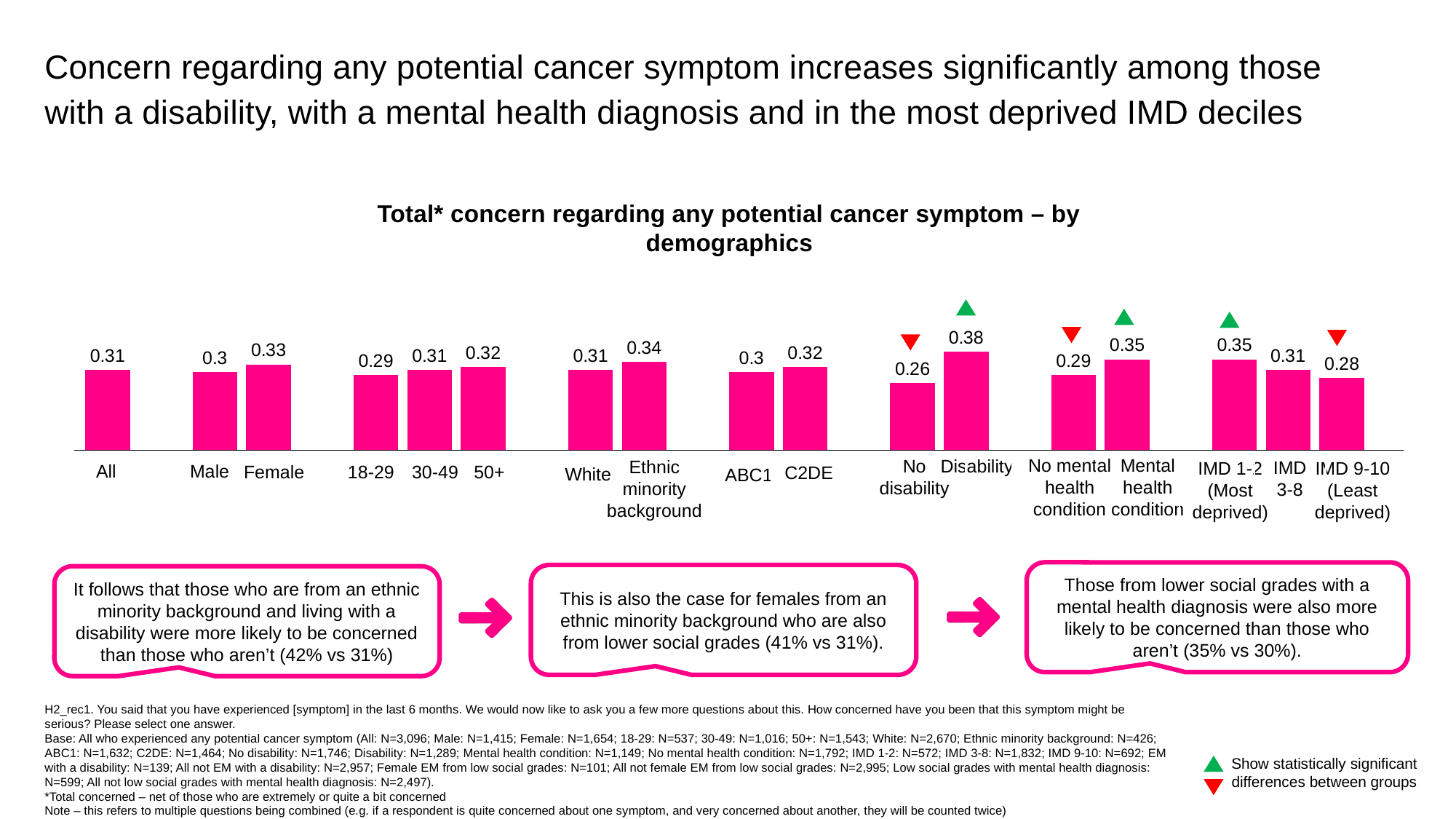
What is the difference between the values for Mental health condition and No mental health condition? 0.06 Which category has the lowest value? No disability What is the title of the chart? Total* concern regarding any potential cancer symptom – by demographics Which category has the highest value? Disability What is the difference between the values for Disability and No disability? 0.12 What is the value for Ethnic minority background? 0.34 What kind of chart is shown? Bar chart What is the value for No disability? 0.26 Which is larger, the value for Female or the value for Male? Female What is the value for Disability? 0.38 How many bars are shown in the chart? 17 What is the value for IMD 9-10 (Least deprived)? 0.28